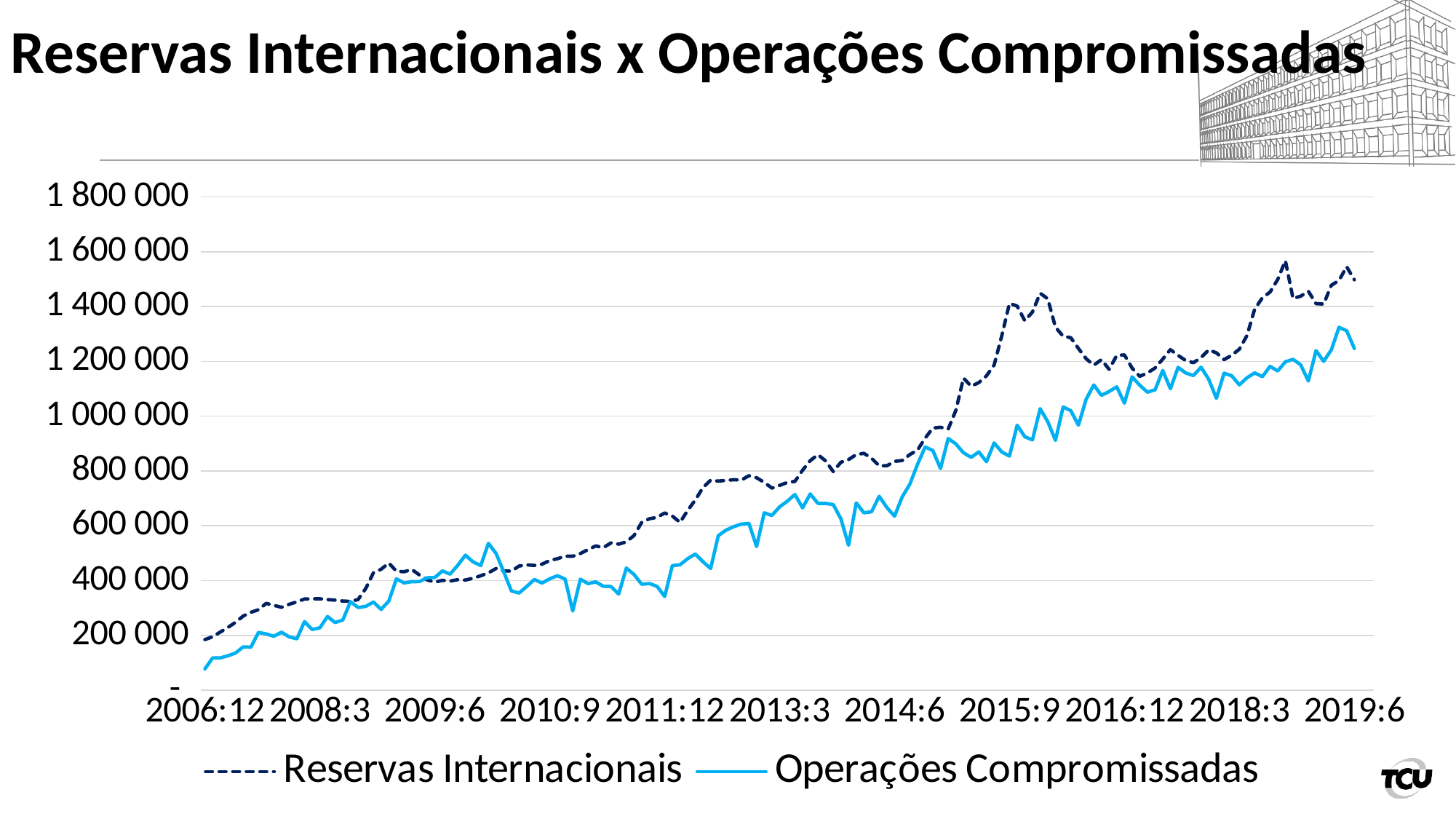
At 2015:9, which series has the higher value, Reservas Internacionais or Operações Compromissadas? Reservas Internacionais How many date labels are shown on the x axis? 11 Is the value of Operações Compromissadas at 2006:12 greater or less than 200 000? less Is the value of Reservas Internacionais at 2019:6 greater or less than 1 400 000? greater What kind of chart is shown on the slide? line chart Overall, do the values of Operações Compromissadas rise or fall from 2006:12 to 2019:6? rise Which series is drawn with a dashed line? Reservas Internacionais How many series does the legend list? 2 Overall, do the values of Reservas Internacionais rise or fall from 2006:12 to 2019:6? rise Is the value of Operações Compromissadas at 2015:9 greater or less than 1 000 000? less Which series reaches the highest value anywhere on the chart? Reservas Internacionais What is the title of the chart? Reservas Internacionais x Operações Compromissadas